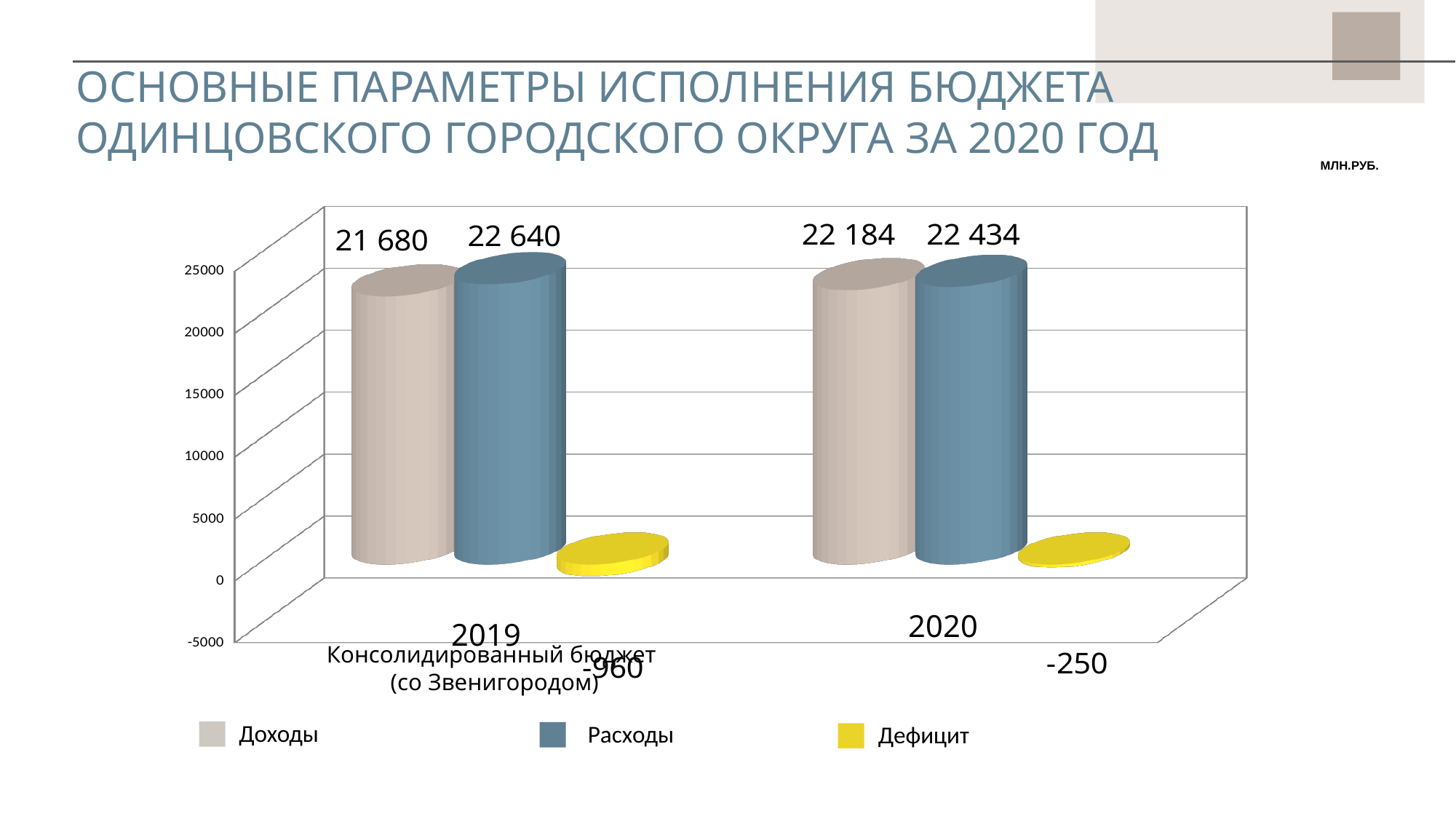
What is the value of Расходы for 2020? 22 434 What is the value of Дефицит for 2020? -250 How many series does the legend list? 3 What is the difference between Расходы and Доходы in 2019? 960 What is the difference between Доходы in 2020 and Доходы in 2019? 504 How many year categories are shown on the x axis? 2 What is the value of Дефицит for 2019? -960 Which is larger: Расходы in 2019 or Расходы in 2020? Расходы in 2019 What is the value of Расходы for 2019? 22 640 Which colour represents Дефицит in the legend? Yellow What is the value of Доходы for 2019? 21 680 What kind of chart is shown on the slide? Bar chart